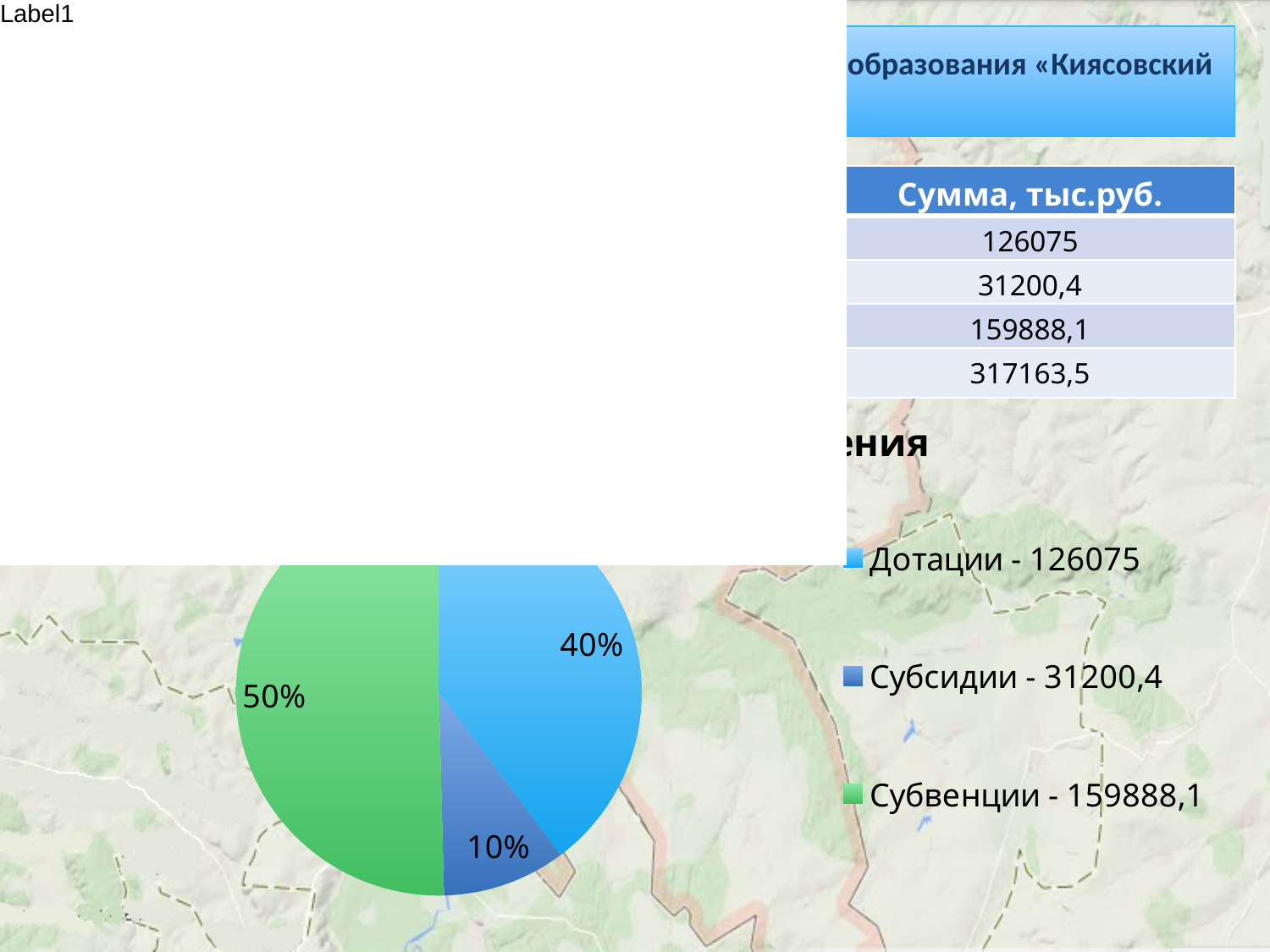
Which legend entry has the largest slice of the pie? Субвенции - 159888,1 How many slices does the pie chart have? 3 What share of the pie does the slice for Субсидии - 31200,4 represent? 10% How many entries does the legend of the pie chart list? 3 What is the difference in percentage points between the Субвенции slice and the Дотации slice? 10% Which legend entry has the smallest slice of the pie? Субсидии - 31200,4 What kind of chart is shown on the slide? pie chart What is the difference in percentage points between the Дотации slice and the Субсидии slice? 30% What share of the pie does the slice for Дотации - 126075 represent? 40% Which slice is larger: Дотации - 126075 or Субсидии - 31200,4? Дотации - 126075 What share of the pie does the slice for Субвенции - 159888,1 represent? 50% What colour is the slice for Субвенции - 159888,1? green